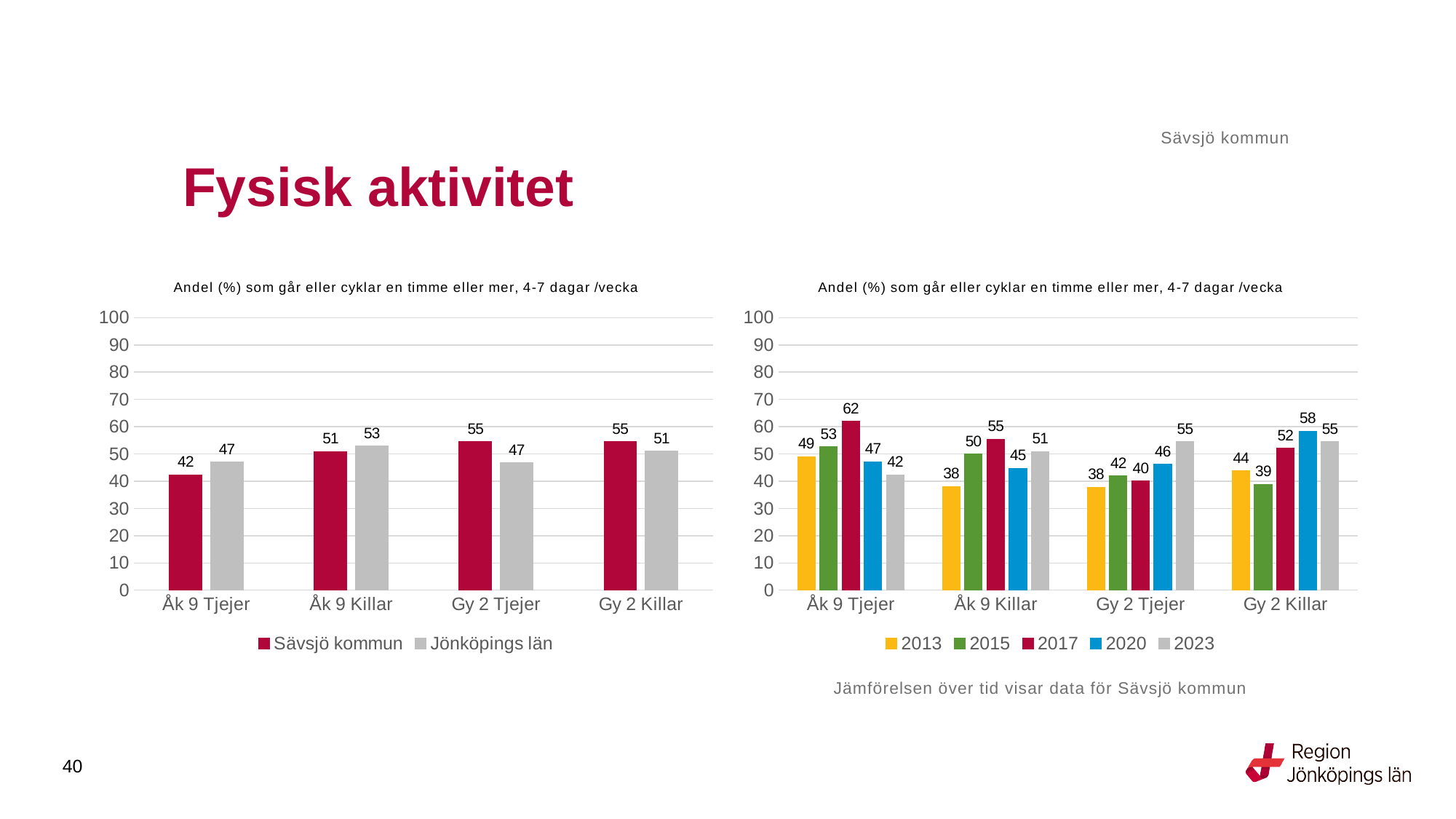
In the right chart, what is the difference between the 2020 and 2015 values for Gy 2 Killar? 19 In the left chart, what is the value for Jönköpings län for Gy 2 Killar? 51 In the left chart, what is the value for Sävsjö kommun for Åk 9 Tjejer? 42 How many series does the legend of the left chart list? 2 In the left chart, what is the difference between Sävsjö kommun and Jönköpings län for Gy 2 Tjejer? 8 In the right chart, which year has the lowest value for Åk 9 Killar? 2013 What kind of chart is the right chart? Bar chart In the right chart, which year has the highest value for Gy 2 Tjejer? 2023 In the right chart, what is the value for 2017 for Åk 9 Tjejer? 62 In the left chart, which is larger for Åk 9 Killar: Sävsjö kommun or Jönköpings län? Jönköpings län In the right chart, what is the value for 2013 for Gy 2 Killar? 44 How many series does the legend of the right chart list? 5